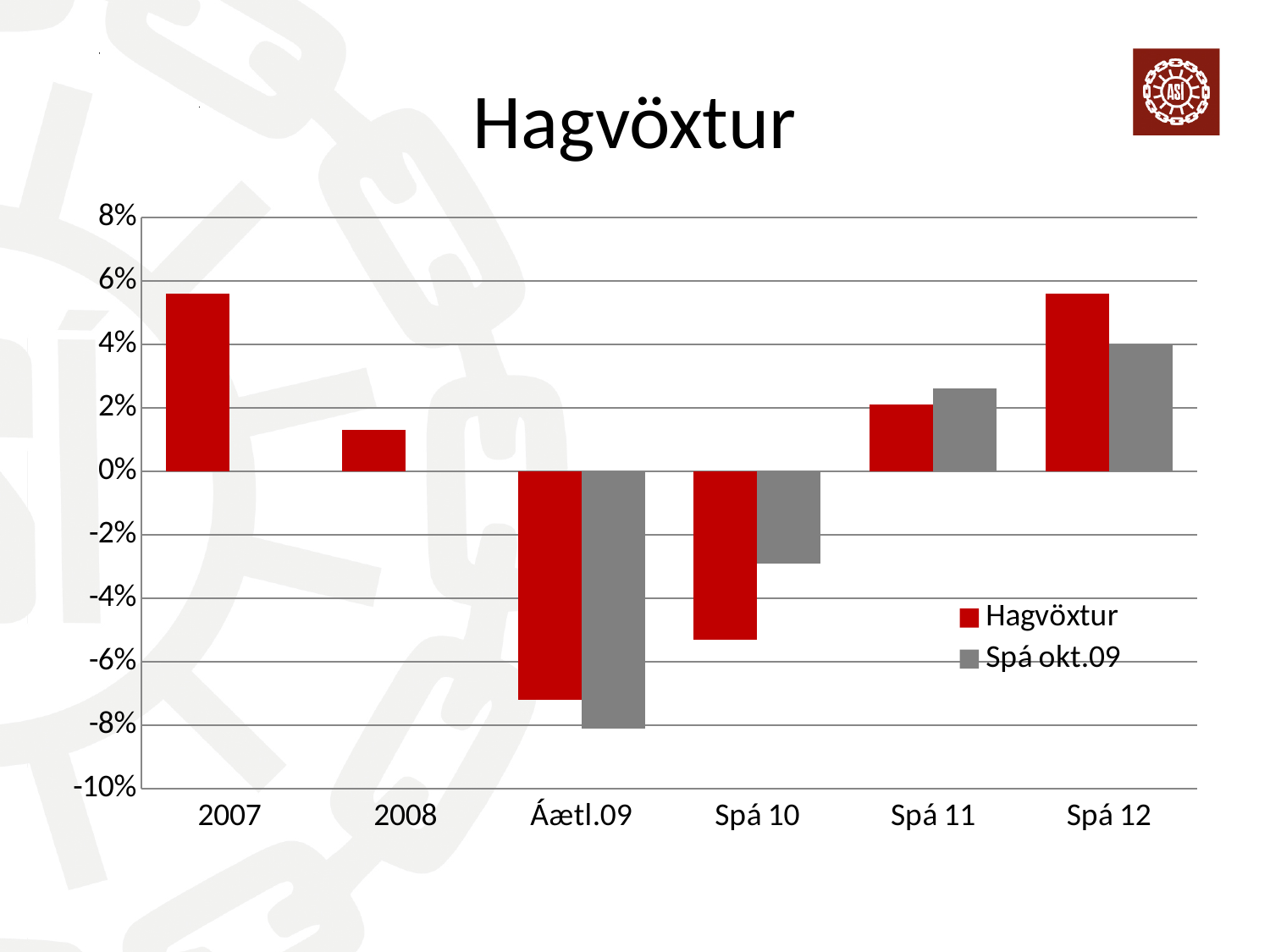
Which category has the highest value for the Spá okt.09 series? Spá 12 What kind of chart is shown on the slide? bar chart For Spá 10, which series has the higher value, Hagvöxtur or Spá okt.09? Spá okt.09 Is the Hagvöxtur value for Spá 10 greater or less than -4%? less Is the Hagvöxtur value for 2008 greater or less than 2%? less For Áætl.09, which series has the lower value, Hagvöxtur or Spá okt.09? Spá okt.09 How many series does the legend list? 2 Which category has the lowest value for the Hagvöxtur series? Áætl.09 What is the title of the chart? Hagvöxtur Which category has the lowest value for the Spá okt.09 series? Áætl.09 Is the Hagvöxtur value for 2007 greater or less than 4%? greater How many categories are shown on the x axis? 6